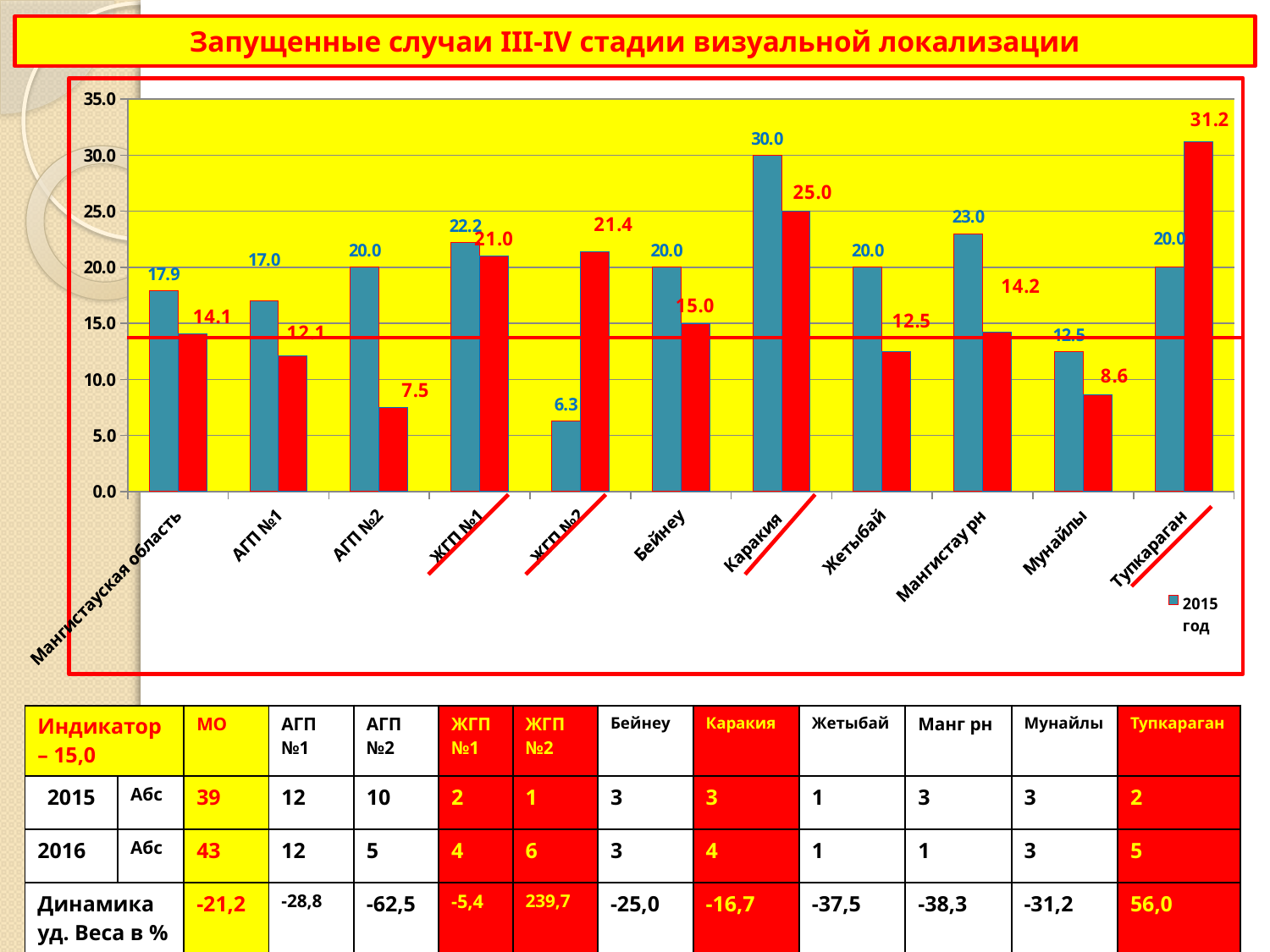
What is the value of the blue (2015 год) bar for Каракия? 30.0 How many categories are shown on the x axis of the chart? 11 What kind of chart is shown on the slide? bar chart For АГП №2, which is larger: the blue bar or the red bar? the blue bar Which category has the lowest blue (2015 год) bar? ЖГП №2 For Каракия, what is the difference between the blue bar and the red bar? 5.0 What is the value of the red bar for Тупкараган? 31.2 Which category has the highest blue (2015 год) bar? Каракия Which category has the lowest red bar? АГП №2 Which category has the highest red bar? Тупкараган What is the value of the red bar for Мунайлы? 8.6 What is the value of the blue (2015 год) bar for ЖГП №1? 22.2